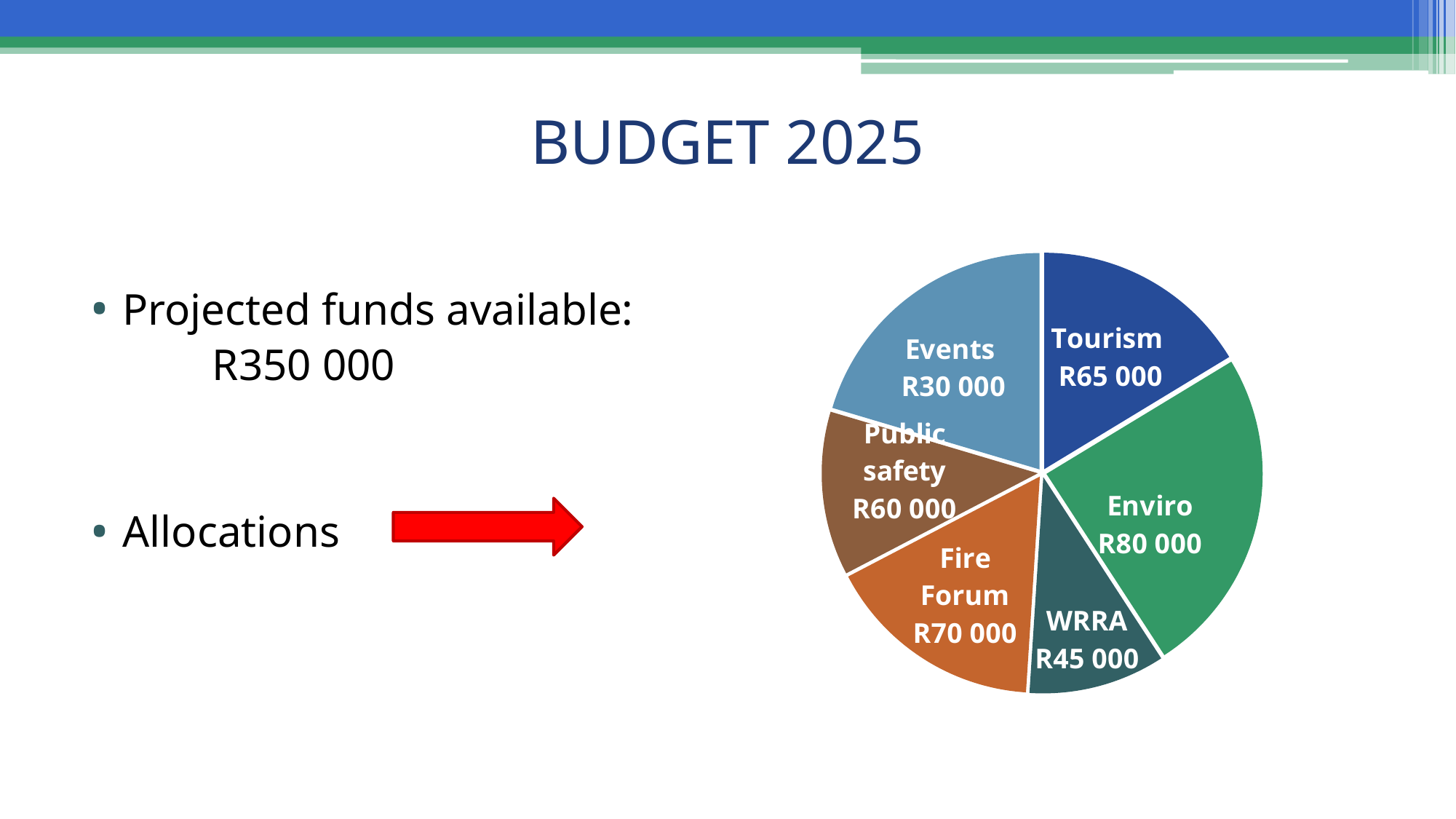
What is the total of all allocations shown in the pie chart? R350 000 What type of chart is shown on the slide? Pie chart Which category receives the largest allocation in the pie chart? Enviro What is the allocation for WRRA in the pie chart? R45 000 What is the difference between the Fire Forum and Events allocations? R40 000 Which is larger, the Tourism allocation or the Public safety allocation? Tourism What is the allocation for Enviro in the pie chart? R80 000 How many categories are shown in the pie chart? 6 What is the allocation for Public safety in the pie chart? R60 000 What share of the total allocations does Fire Forum receive? 20% What is the difference between the Enviro and Tourism allocations? R15 000 Which category receives the smallest allocation in the pie chart? Events